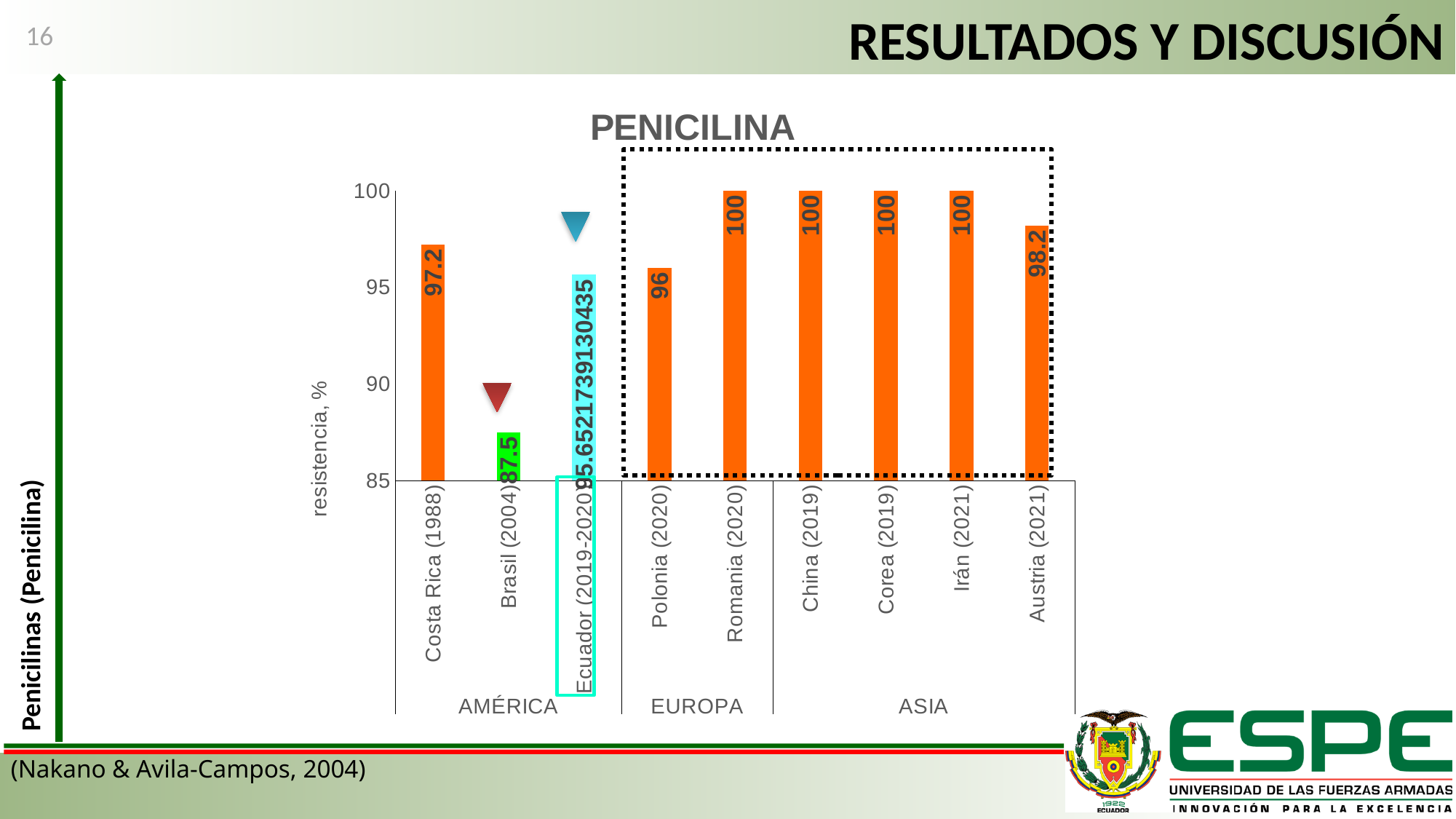
What is the difference between the values for Romania (2020) and Austria (2021)? 1.8 What is the value for Polonia (2020)? 96 What kind of chart is shown on the slide? bar chart Is the value for Brasil (2004) greater or less than 90? less What is the value for Costa Rica (1988)? 97.2 What is the label of the vertical axis? resistencia, % Which is larger, the value for Austria (2021) or the value for Polonia (2020)? Austria (2021) What is the title of the chart? PENICILINA What is the value for Austria (2021)? 98.2 Which category has the lowest value? Brasil (2004) What is the difference between the values for Costa Rica (1988) and Polonia (2020)? 1.2 What is the value for Romania (2020)? 100